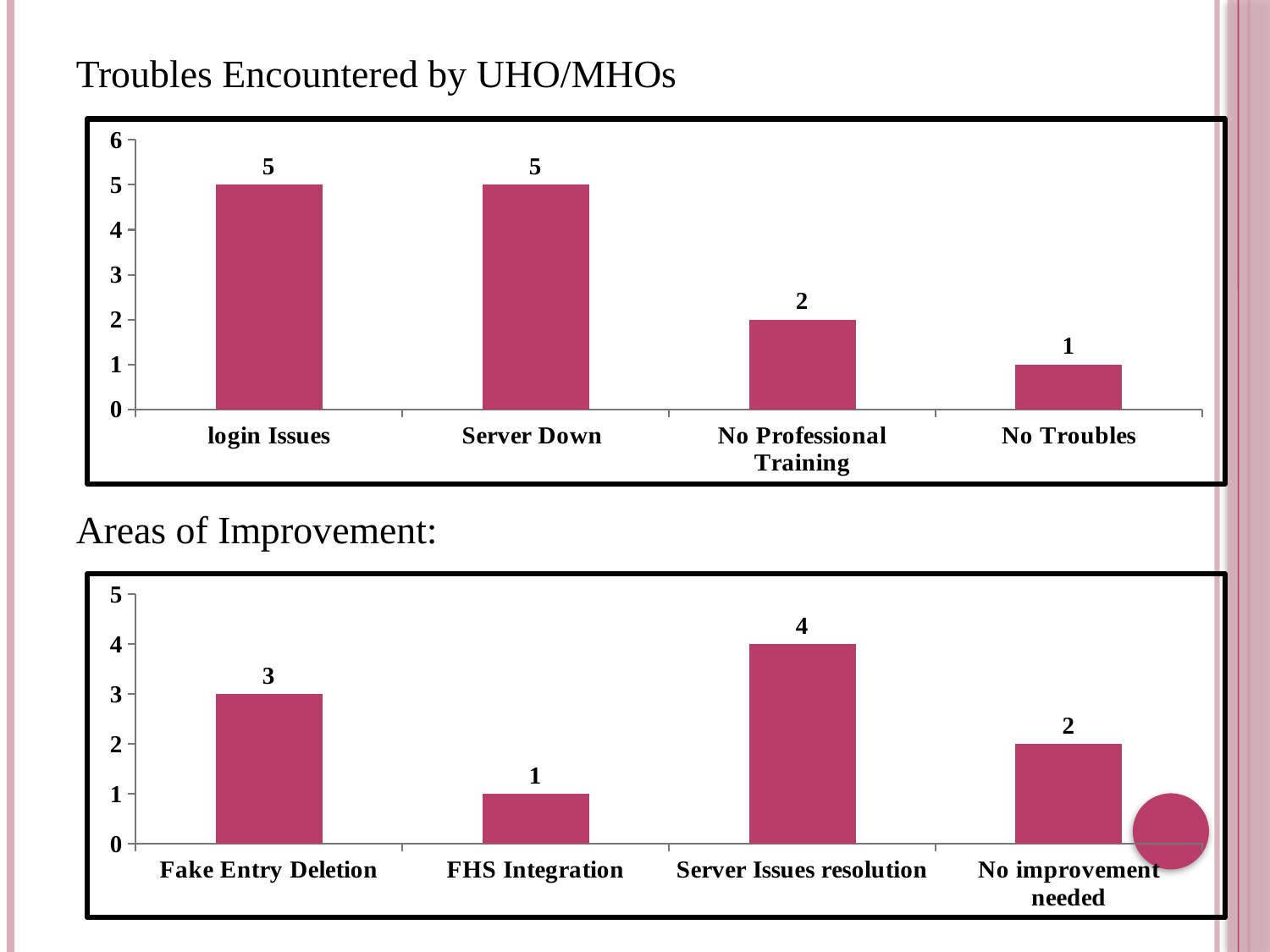
In the 'Troubles Encountered by UHO/MHOs' chart, what is the value for No Professional Training? 2 In the 'Troubles Encountered by UHO/MHOs' chart, how many categories are shown? 4 In the 'Areas of Improvement' chart, what is the difference between Server Issues resolution and FHS Integration? 3 In the 'Troubles Encountered by UHO/MHOs' chart, which category has the lowest value? No Troubles In the 'Troubles Encountered by UHO/MHOs' chart, is the value for login Issues greater or less than 3? greater In the 'Areas of Improvement' chart, which category has the highest value? Server Issues resolution In the 'Areas of Improvement' chart, which is larger: Fake Entry Deletion or No improvement needed? Fake Entry Deletion In the 'Troubles Encountered by UHO/MHOs' chart, what is the difference between login Issues and No Troubles? 4 In the 'Areas of Improvement' chart, what is the value for Fake Entry Deletion? 3 In the 'Areas of Improvement' chart, which category has the lowest value? FHS Integration In the 'Troubles Encountered by UHO/MHOs' chart, what is the value for Server Down? 5 What type of chart is the 'Areas of Improvement' chart? Bar chart